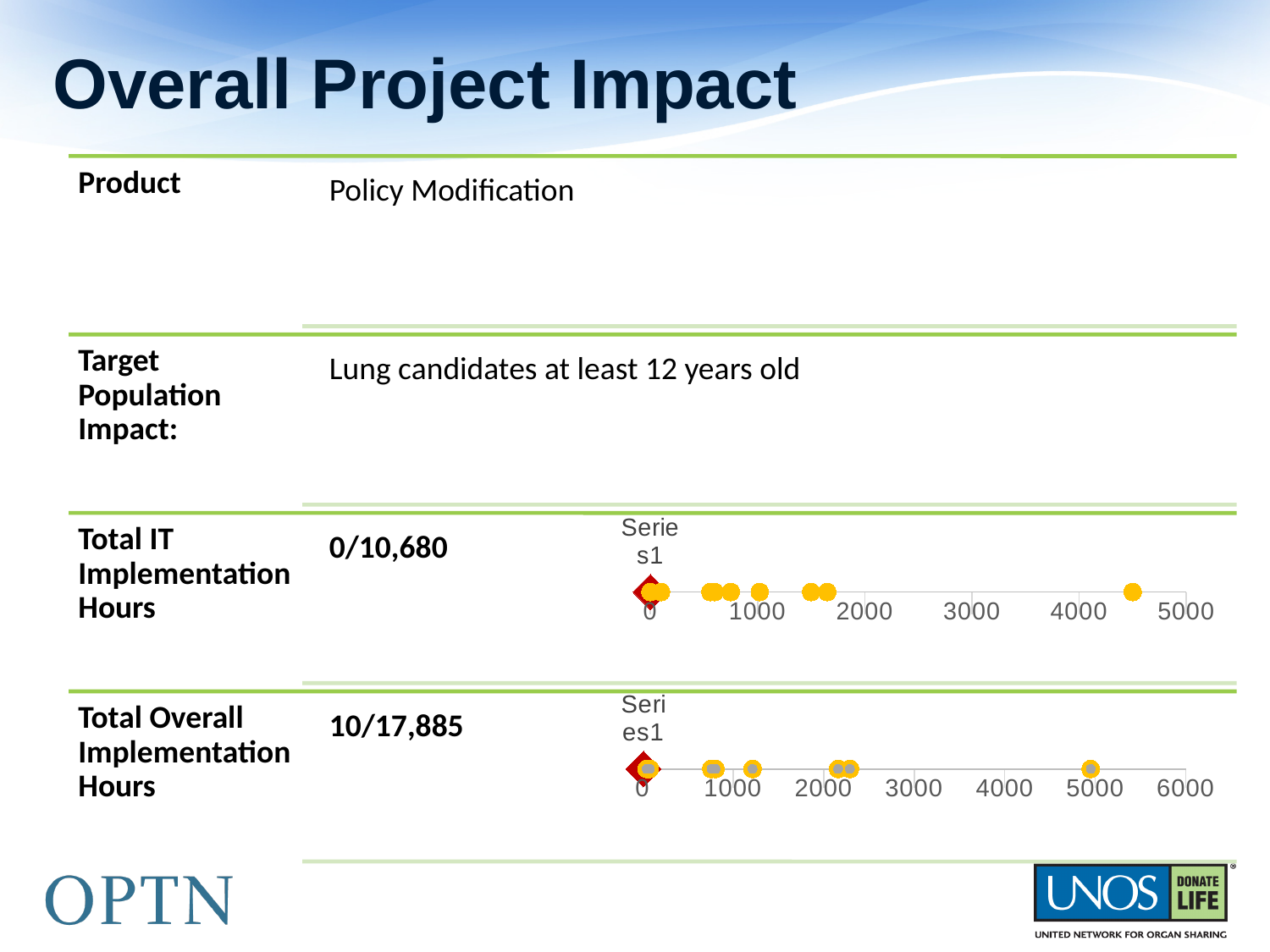
In the chart next to "Total IT Implementation Hours", what is the highest value labelled on the x axis? 5000 In the chart next to "Total IT Implementation Hours", is the rightmost plotted point greater or less than 4000? greater In the chart next to "Total IT Implementation Hours", is the red diamond marker greater or less than 1000? less In the chart next to "Total Overall Implementation Hours", is the rightmost plotted point greater or less than 4000? greater What kind of chart is shown next to "Total IT Implementation Hours"? scatter chart In the chart next to "Total Overall Implementation Hours", what is the highest value labelled on the x axis? 6000 What kind of chart is shown next to "Total Overall Implementation Hours"? scatter chart How many charts are shown on the slide? 2